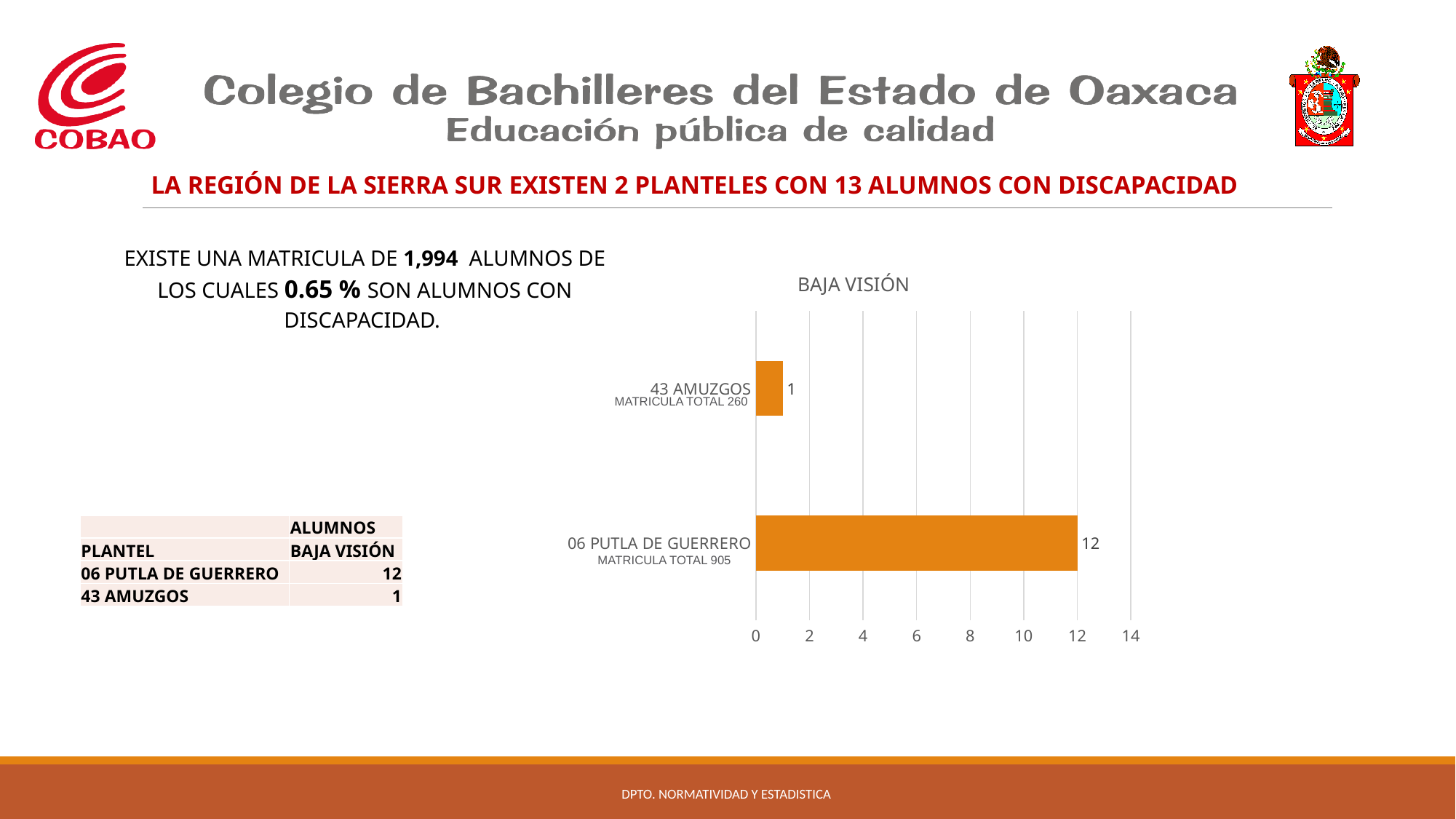
Which has a larger value in the BAJA VISIÓN chart, 43 AMUZGOS or 06 PUTLA DE GUERRERO? 06 PUTLA DE GUERRERO What kind of chart is the BAJA VISIÓN chart? bar chart What is the title of the chart on the slide? BAJA VISIÓN Is the value for 43 AMUZGOS in the BAJA VISIÓN chart greater or less than 2? less Which plantel has the highest value in the BAJA VISIÓN chart? 06 PUTLA DE GUERRERO Is the value for 06 PUTLA DE GUERRERO in the BAJA VISIÓN chart greater or less than 10? greater How many planteles are shown in the BAJA VISIÓN chart? 2 Which plantel has the lowest value in the BAJA VISIÓN chart? 43 AMUZGOS What is the difference between the values for 06 PUTLA DE GUERRERO and 43 AMUZGOS in the BAJA VISIÓN chart? 11 What is the value for 06 PUTLA DE GUERRERO in the BAJA VISIÓN chart? 12 What is the value for 43 AMUZGOS in the BAJA VISIÓN chart? 1 What is the maximum value shown on the x axis of the BAJA VISIÓN chart? 14